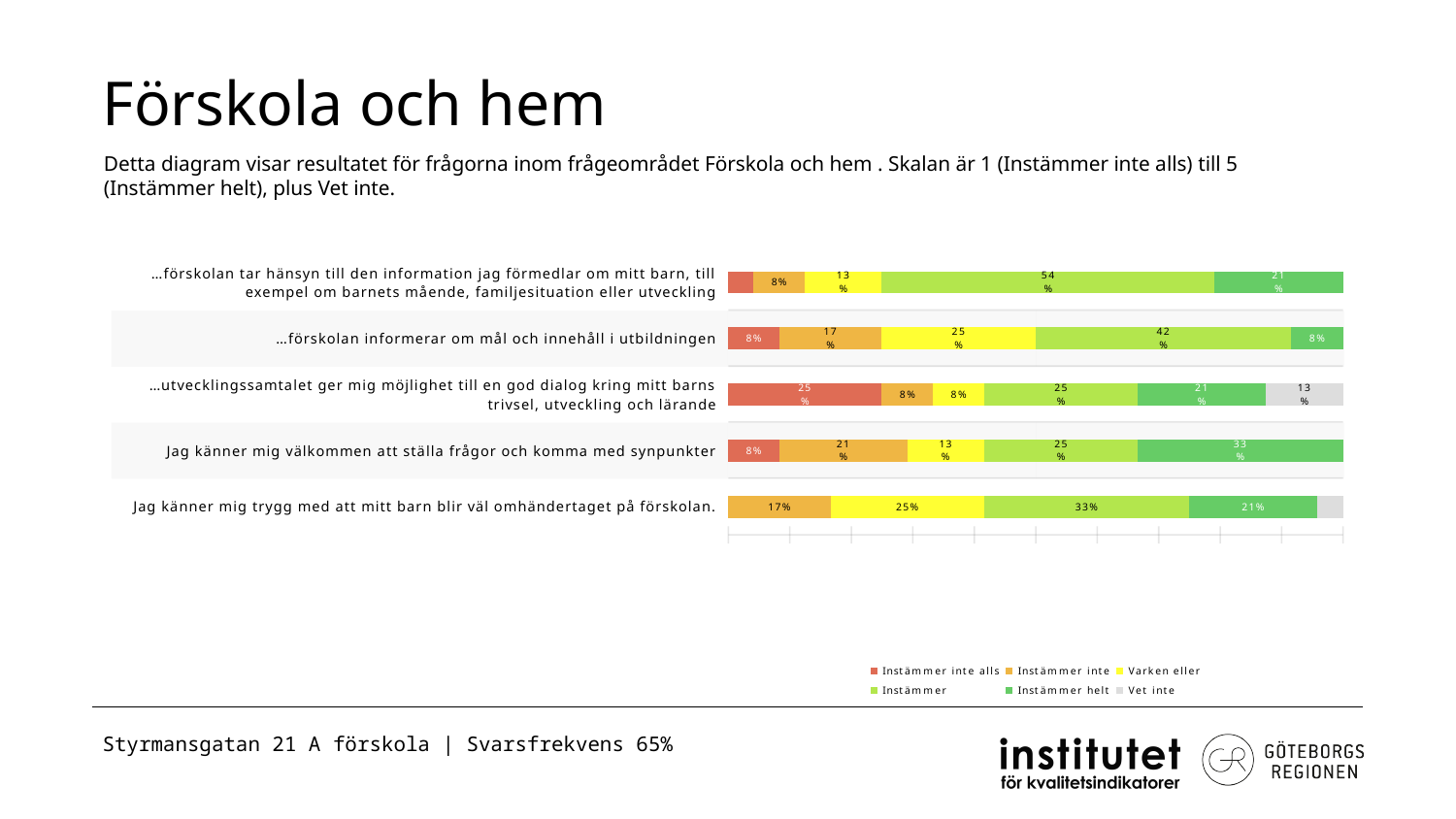
What is the 'Instämmer helt' value for 'Jag känner mig välkommen att ställa frågor och komma med synpunkter'? 33% Which is larger: the 'Instämmer helt' value for 'Jag känner mig välkommen att ställa frågor och komma med synpunkter' or for '…förskolan informerar om mål och innehåll i utbildningen'? Jag känner mig välkommen att ställa frågor och komma med synpunkter What is the 'Instämmer inte alls' value for '…utvecklingssamtalet ger mig möjlighet till en god dialog kring mitt barns trivsel, utveckling och lärande'? 25% What is the title of the slide containing the chart? Förskola och hem What kind of chart is shown on the slide? Stacked bar chart What is the 'Vet inte' value for '…utvecklingssamtalet ger mig möjlighet till en god dialog kring mitt barns trivsel, utveckling och lärande'? 13% What is the difference between the 'Instämmer' value for '…förskolan informerar om mål och innehåll i utbildningen' (42%) and its 'Instämmer helt' value (8%)? 34% What is the 'Varken eller' value for 'Jag känner mig trygg med att mitt barn blir väl omhändertaget på förskolan'? 25% How many statements (categories) are plotted in the chart? 5 What is the 'Instämmer' value for '…förskolan tar hänsyn till den information jag förmedlar om mitt barn, till exempel om barnets mående, familjesituation eller utveckling'? 54% Which statement has the highest 'Instämmer' value? …förskolan tar hänsyn till den information jag förmedlar om mitt barn, till exempel om barnets mående, familjesituation eller utveckling How many series does the legend list? 6